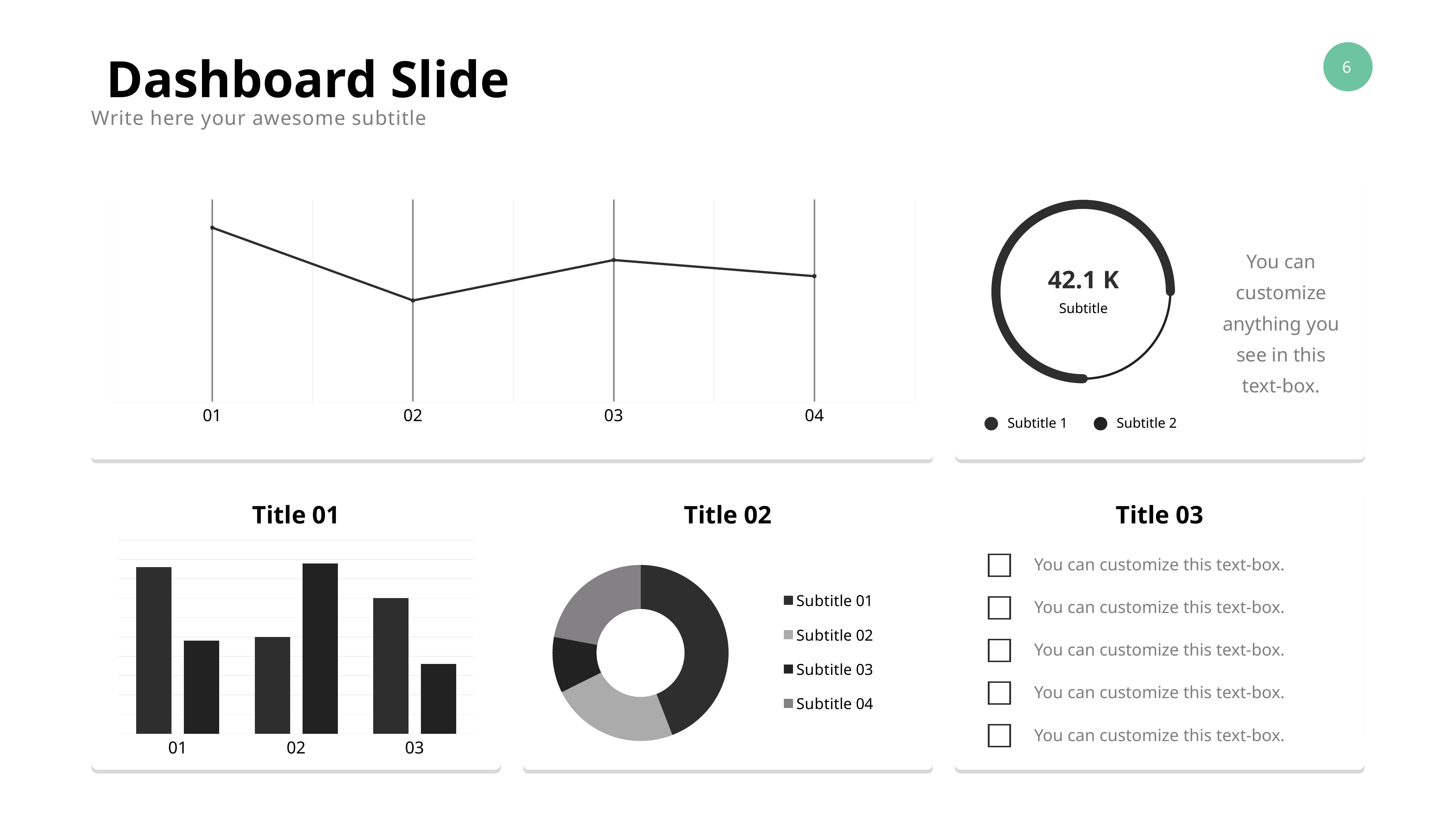
On the line chart at the top left, is the value for 01 larger or smaller than the value for 02? larger On the chart titled Title 02, which legend entry has the largest slice? Subtitle 01 How many categories are shown on the x axis of the chart titled Title 01? 3 On the chart titled Title 01, which category contains the tallest bar? 02 What value is printed in the centre of the circular gauge at the top right of the slide? 42.1 K On the line chart at the top left, which category has the lowest value? 02 What kind of chart is the chart titled Title 01? bar chart On the line chart at the top left, which category has the highest value? 01 How many data points are plotted on the line chart at the top left of the slide? 4 How many entries does the legend of the chart titled Title 02 list? 4 What kind of chart is the chart at the top left of the slide with categories 01 to 04? line chart On the line chart at the top left, does the line rise or fall from 02 to 03? rise